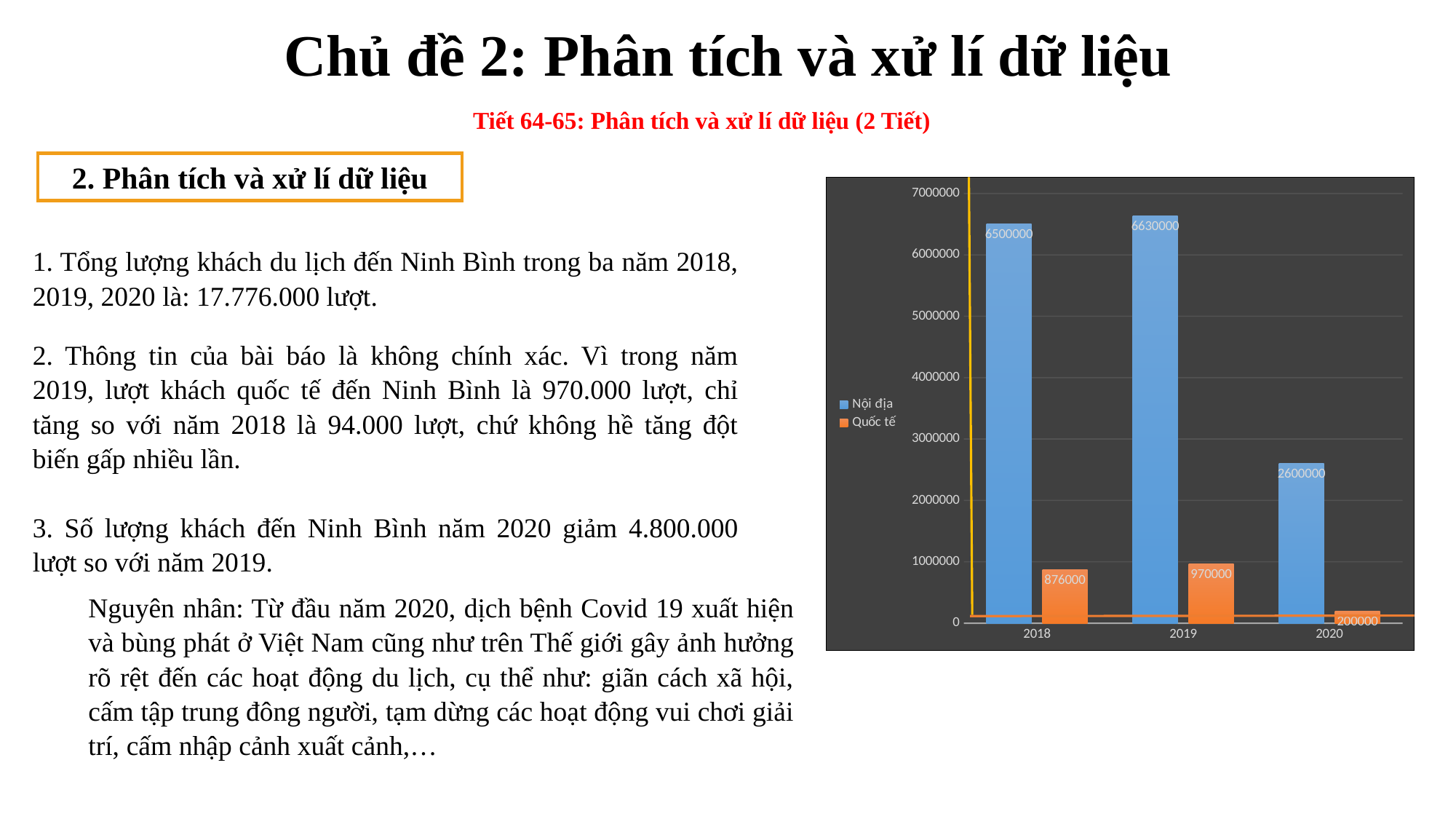
What type of chart is shown on the slide? Bar chart In which year is the Nội địa value highest? 2019 In which year is the Quốc tế value lowest? 2020 What is the value of Quốc tế for 2019? 970000 Which is larger: the Nội địa value for 2018 or the Nội địa value for 2020? 2018 What is the difference between the Quốc tế values for 2019 and 2018? 94000 What is the value of Nội địa for 2020? 2600000 How many series does the chart legend list? 2 What is the value of Quốc tế for 2020? 200000 How many years (categories) are shown on the x axis? 3 Which colour represents the Quốc tế series in the chart? Orange What is the value of Nội địa for 2018? 6500000